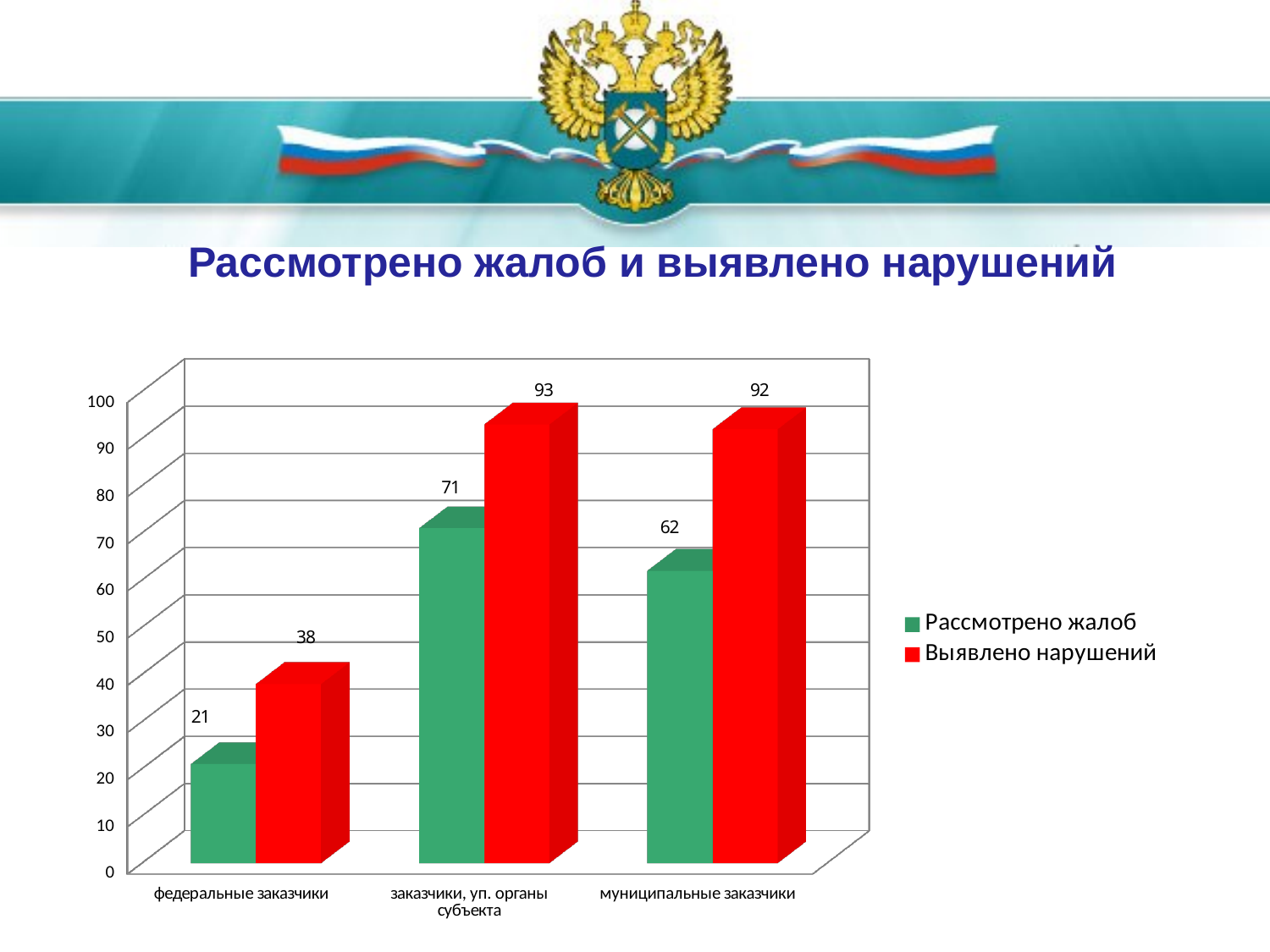
How many series does the legend list? 2 What is the difference between "Выявлено нарушений" and "Рассмотрено жалоб" for "федеральные заказчики"? 17 What is the value of "Выявлено нарушений" for "заказчики, уп. органы субъекта"? 93 Which category has the lowest value for "Выявлено нарушений"? федеральные заказчики What is the value of "Рассмотрено жалоб" for "федеральные заказчики"? 21 What is the difference between "Выявлено нарушений" and "Рассмотрено жалоб" for "муниципальные заказчики"? 30 Which category has the highest value for "Рассмотрено жалоб"? заказчики, уп. органы субъекта What is the value of "Рассмотрено жалоб" for "муниципальные заказчики"? 62 Which is larger: "Рассмотрено жалоб" for "заказчики, уп. органы субъекта" or "Рассмотрено жалоб" for "муниципальные заказчики"? заказчики, уп. органы субъекта What kind of chart is shown on the slide? bar chart How many categories are shown on the x axis? 3 What colour represents the "Выявлено нарушений" series? red